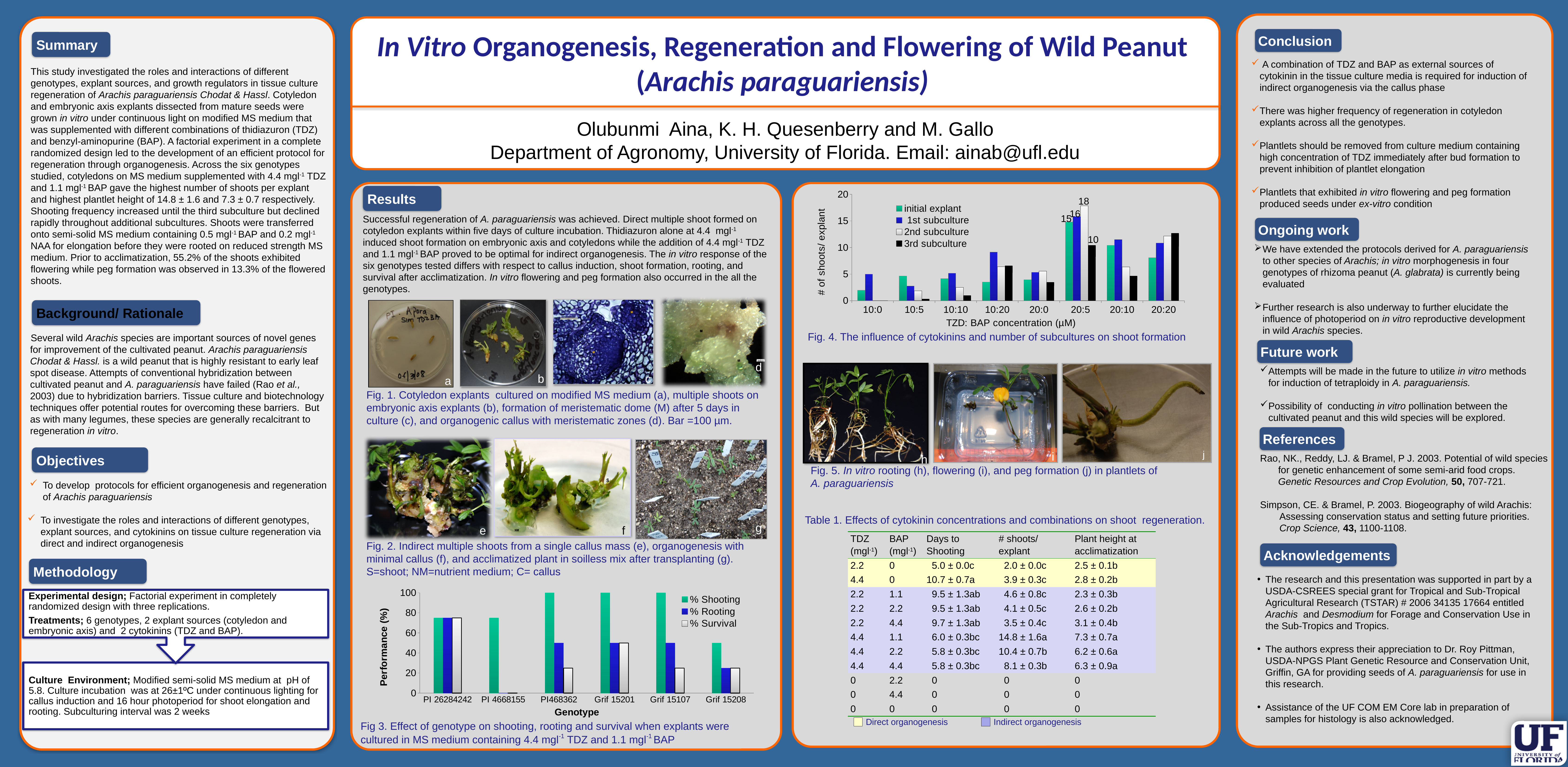
In Fig. 3, how many genotypes are shown on the x axis? 6 In Fig. 4, how many TZD:BAP concentration categories are shown on the x axis? 8 In Fig. 4, is the initial explant value at the 10:0 concentration greater or less than 5? less In Fig. 3, how many series does the legend list? 3 In Fig. 4, which TZD:BAP concentration gives the highest number of shoots per explant for the 2nd subculture? 20:5 In Fig. 3, is the % Shooting value for Grif 15208 greater or less than 60? less What kind of chart is Fig. 3 (effect of genotype on shooting, rooting and survival)? bar chart In Fig. 4, at the 20:5 concentration, how much higher is the 2nd subculture value than the initial explant value? 3 What kind of chart is Fig. 4 (the influence of cytokinins and number of subcultures on shoot formation)? bar chart In Fig. 4, what is the number of shoots per explant for the 3rd subculture at the 20:5 concentration? 10 In Fig. 4, what is the number of shoots per explant for the 2nd subculture at the 20:5 concentration? 18 In Fig. 4, how many series does the legend list? 4